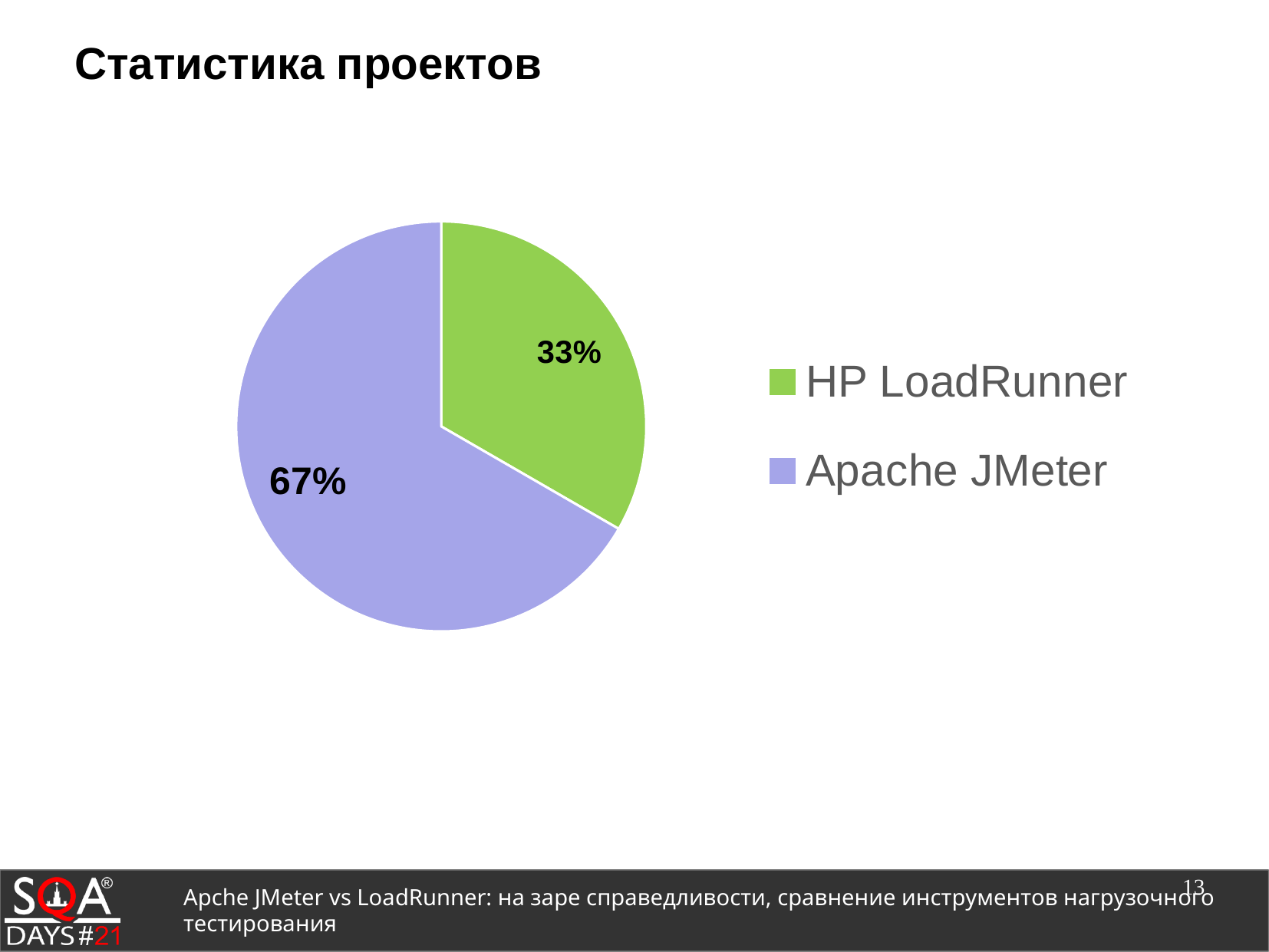
What colour is the Apache JMeter slice? purple Which tool has the largest slice of the pie? Apache JMeter What share of the pie does HP LoadRunner have? 33% Which tool has the smallest slice of the pie? HP LoadRunner How many slices does the pie chart have? 2 What is the difference in percentage points between the Apache JMeter slice and the HP LoadRunner slice? 34 Which slice is larger, HP LoadRunner or Apache JMeter? Apache JMeter What colour is the HP LoadRunner slice? green What kind of chart is shown on the slide? pie chart How many entries does the legend list? 2 What share of the pie does Apache JMeter have? 67%